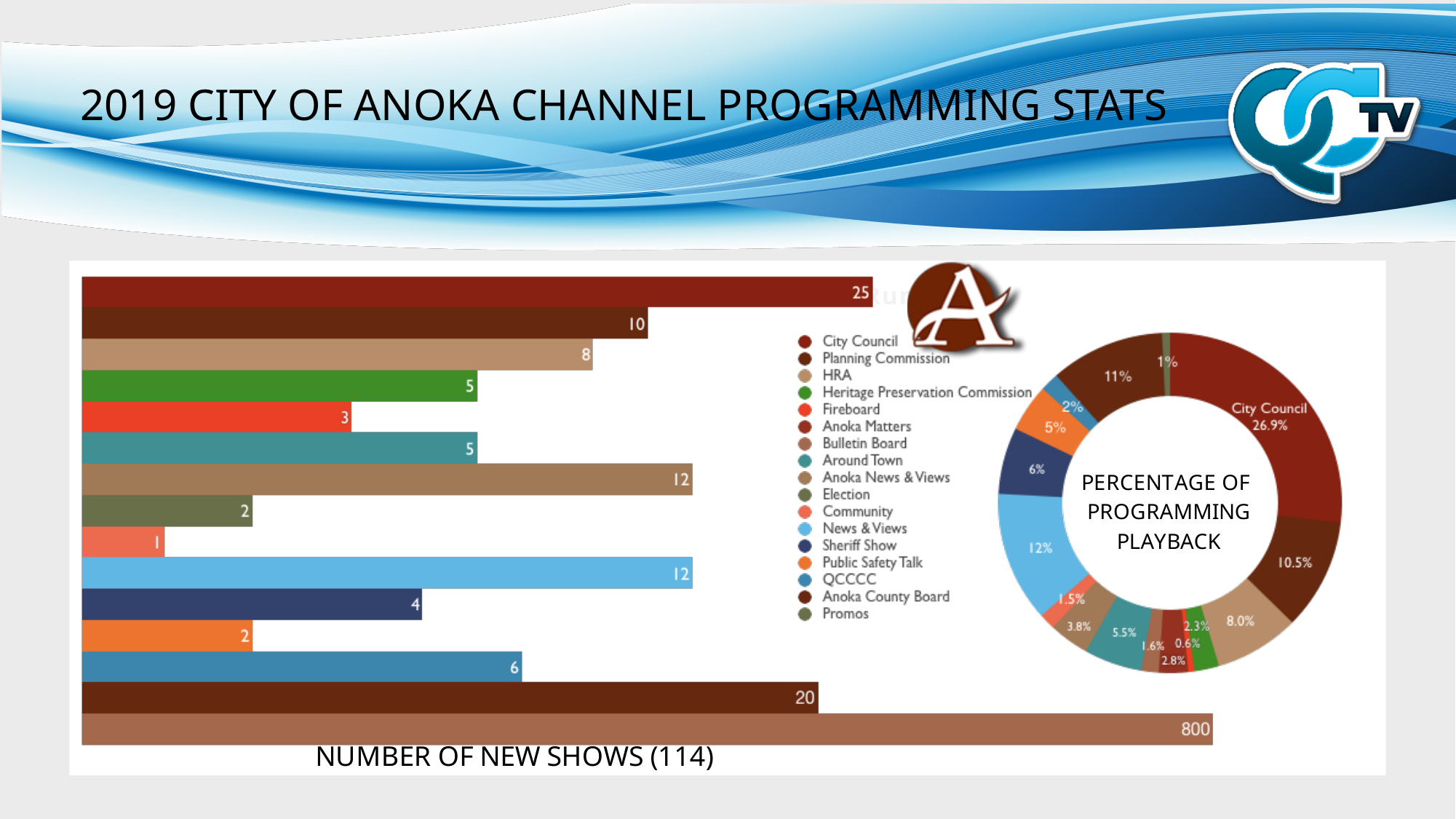
In the bar chart titled NUMBER OF NEW SHOWS (114), what is the value of the City Council bar? 25 In the bar chart titled NUMBER OF NEW SHOWS (114), what is the difference between the City Council bar and the Planning Commission bar? 15 What kind of chart is the chart on the left of the slide, titled NUMBER OF NEW SHOWS (114)? Bar chart In the bar chart titled NUMBER OF NEW SHOWS (114), which is larger: the Sheriff Show bar or the QCCCC bar? QCCCC In the bar chart titled NUMBER OF NEW SHOWS (114), how many bars are plotted? 15 In the bar chart titled NUMBER OF NEW SHOWS (114), what is the value of the longest bar? 800 In the bar chart titled NUMBER OF NEW SHOWS (114), what is the value of the HRA bar? 8 In the bar chart titled NUMBER OF NEW SHOWS (114), what is the value of the shortest bar? 1 In the bar chart titled NUMBER OF NEW SHOWS (114), what is the value of the Anoka County Board bar? 20 In the bar chart titled NUMBER OF NEW SHOWS (114), what is the value of the Planning Commission bar? 10 In the donut chart titled PERCENTAGE OF PROGRAMMING PLAYBACK, what share does City Council have? 26.9% How many entries does the legend between the two charts list? 17